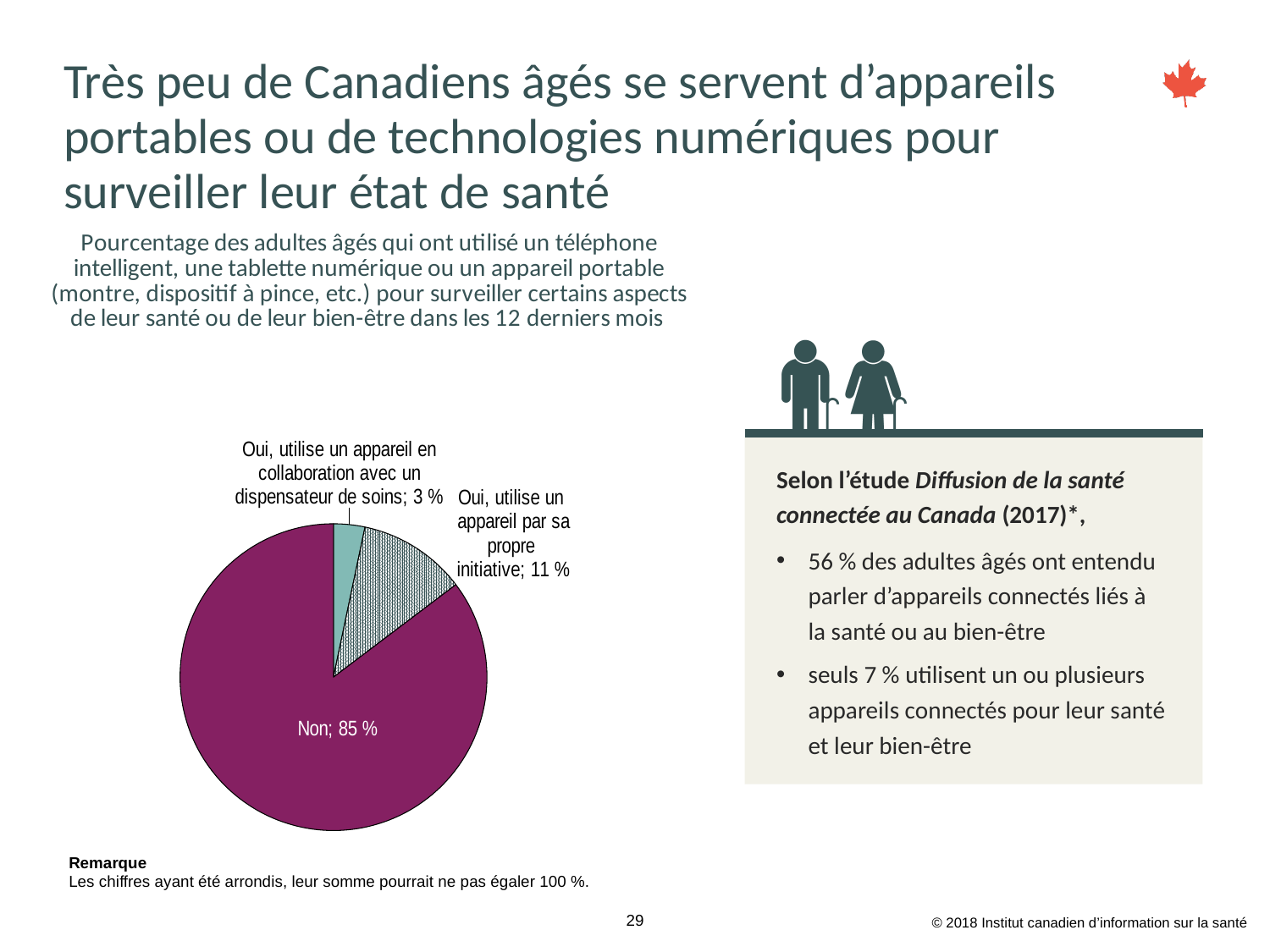
What percentage of older adults answered "Non"? 85 % What is the combined share of the two "Oui" slices? 14 % What is the value for "Oui, utilise un appareil en collaboration avec un dispensateur de soins"? 3 % What kind of chart is shown on the slide? Pie chart How many slices does the pie chart have? 3 Which slice of the pie chart is the smallest? Oui, utilise un appareil en collaboration avec un dispensateur de soins Which slice of the pie chart is the largest? Non What is the difference between the "Non" slice and the "Oui, utilise un appareil par sa propre initiative" slice? 74 % What is the value for "Oui, utilise un appareil par sa propre initiative"? 11 % According to the note below the chart, why might the values not sum to 100 %? Les chiffres ayant été arrondis What colour is the "Non" slice of the pie chart? Purple Which is larger: the slice for using a device on one's own initiative or the slice for using a device in collaboration with a care provider? Oui, utilise un appareil par sa propre initiative